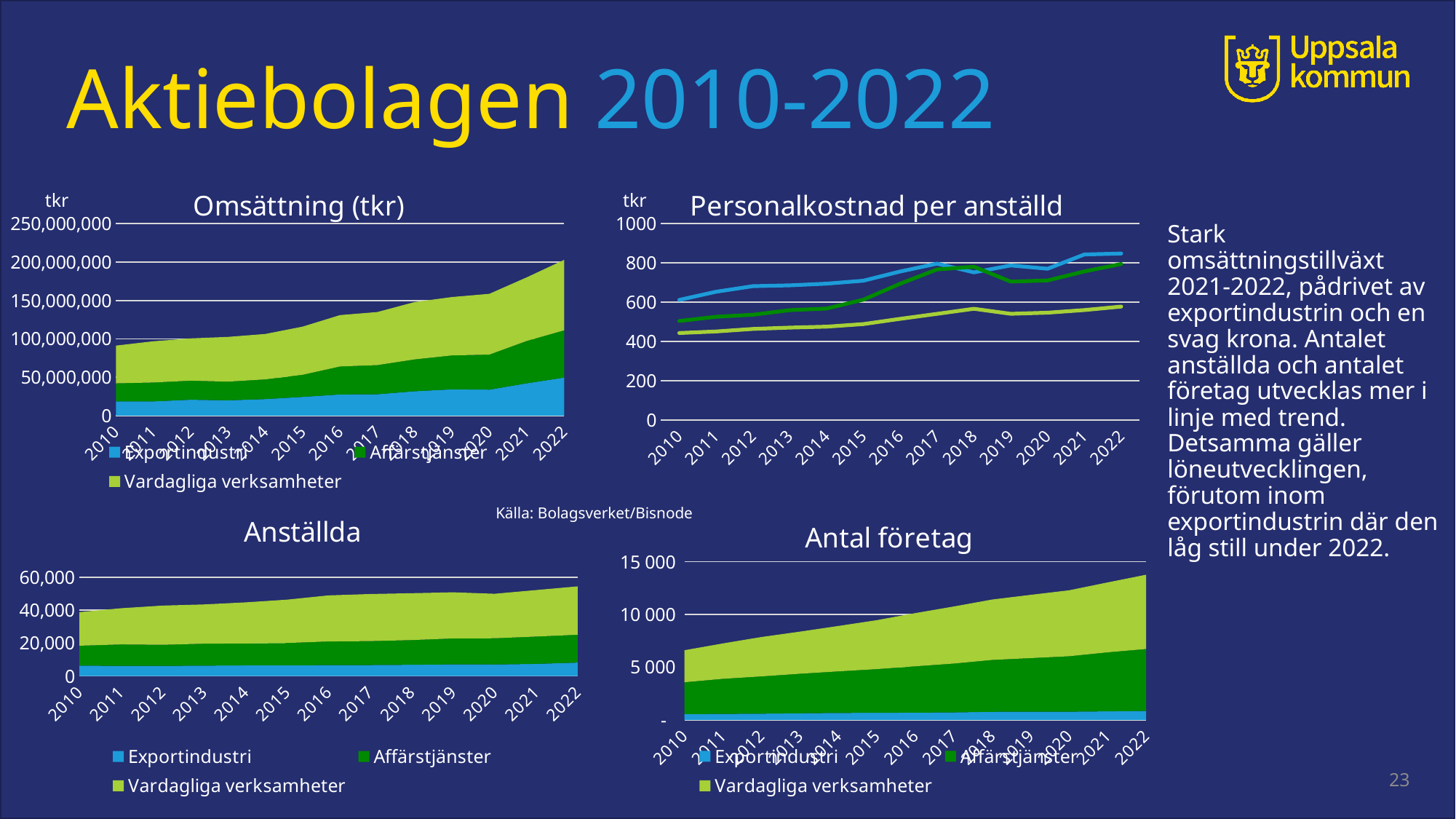
In the 'Personalkostnad per anställd' chart, is the value for Vardagliga verksamheter in 2010 greater or less than 600? less In the 'Antal företag' chart, does the total number of companies rise or fall from 2010 to 2022? Rise In the 'Personalkostnad per anställd' chart, which series is higher in 2010, Exportindustri or Vardagliga verksamheter? Exportindustri How many years are shown on the x axis of the 'Antal företag' chart? 13 What kind of chart is the 'Personalkostnad per anställd' chart? Line chart How many series does the legend of the 'Anställda' chart list? 3 In the 'Personalkostnad per anställd' chart, is the value for Exportindustri in 2022 greater or less than 800? greater In the 'Anställda' chart, is the total stacked value in 2022 greater or less than 40,000? greater What kind of chart is the 'Omsättning (tkr)' chart? Stacked area chart What source is cited for the charts on the slide? Bolagsverket/Bisnode